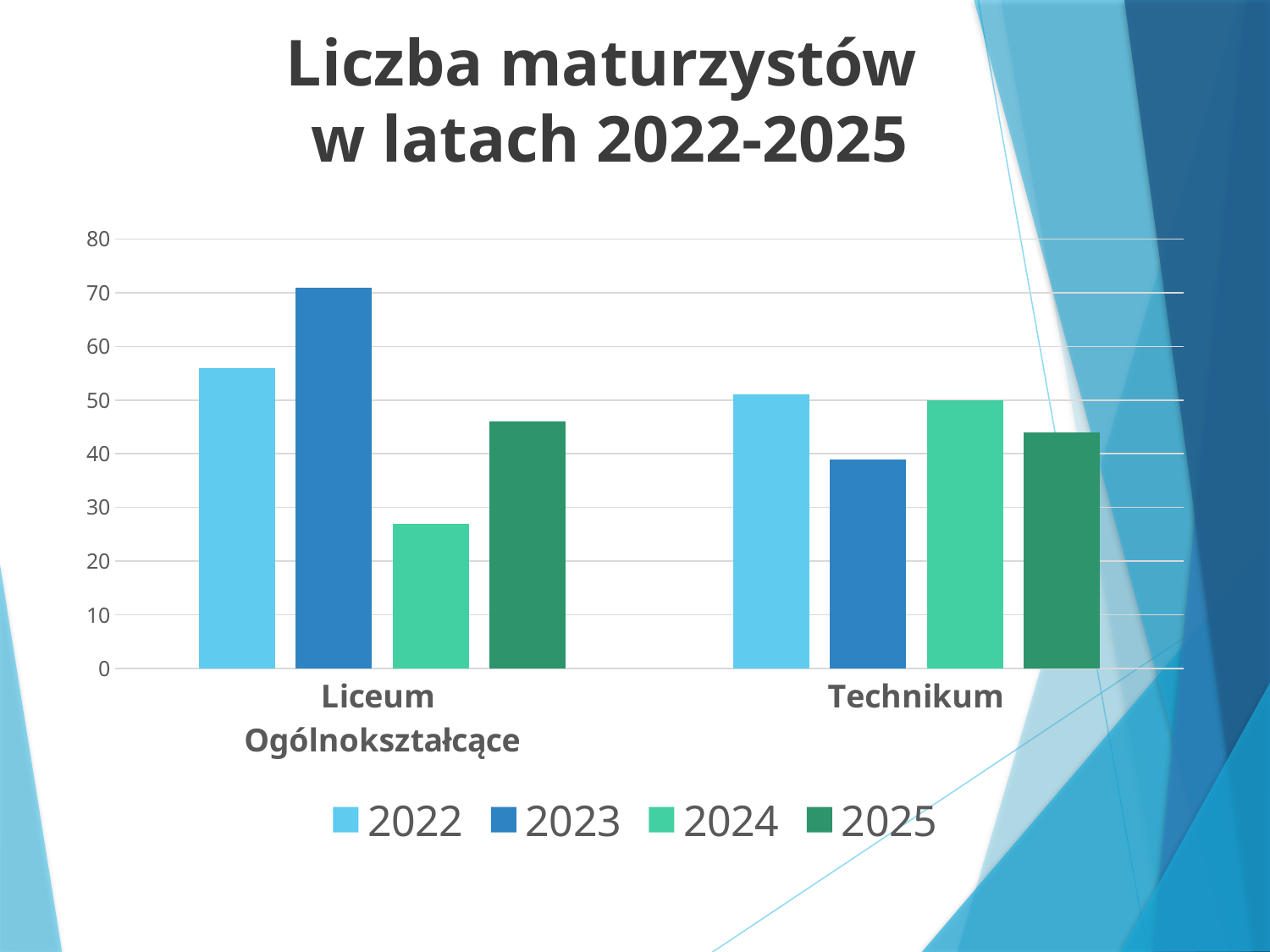
Which year has the highest bar for Liceum Ogólnokształcące? 2023 Is the value for Technikum in 2025 greater or less than 50? less What kind of chart is shown on the slide? bar chart Which year has the lowest bar for Technikum? 2023 How many categories are shown on the x axis? 2 Which year has the lowest bar for Liceum Ogólnokształcące? 2024 Is the value for Liceum Ogólnokształcące in 2024 greater or less than 30? less How many series does the legend list? 4 Which is larger in 2022: Liceum Ogólnokształcące or Technikum? Liceum Ogólnokształcące What is the title of the chart? Liczba maturzystów w latach 2022-2025 Is the value for Liceum Ogólnokształcące in 2023 greater or less than 60? greater Which is larger in 2024: Liceum Ogólnokształcące or Technikum? Technikum